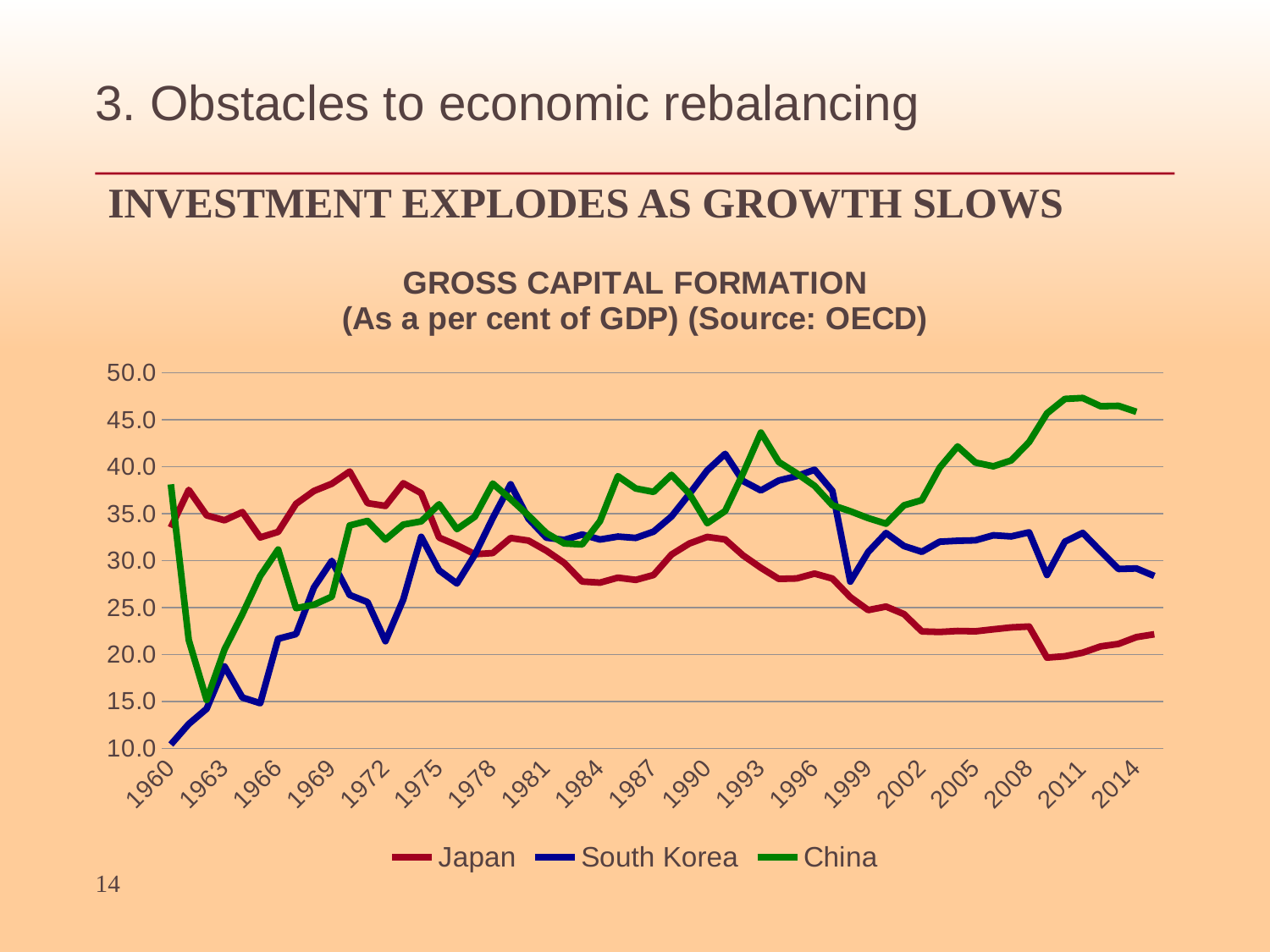
Is the value for China in 2011 greater or less than 45.0? greater What kind of chart is shown on the slide? line chart Which colour is used for the China line? green How many series does the legend list? 3 Is the value for Japan in 2014 greater or less than 25.0? less Which series has the highest value in 2014? China Is the value for South Korea in 1960 greater or less than 15.0? less Does the Japan line rise or fall between 1990 and 2014? fall Which series has the lowest value in 1960? South Korea What is the title of the chart? GROSS CAPITAL FORMATION (As a per cent of GDP) (Source: OECD) In 1963, which is higher, Japan or South Korea? Japan